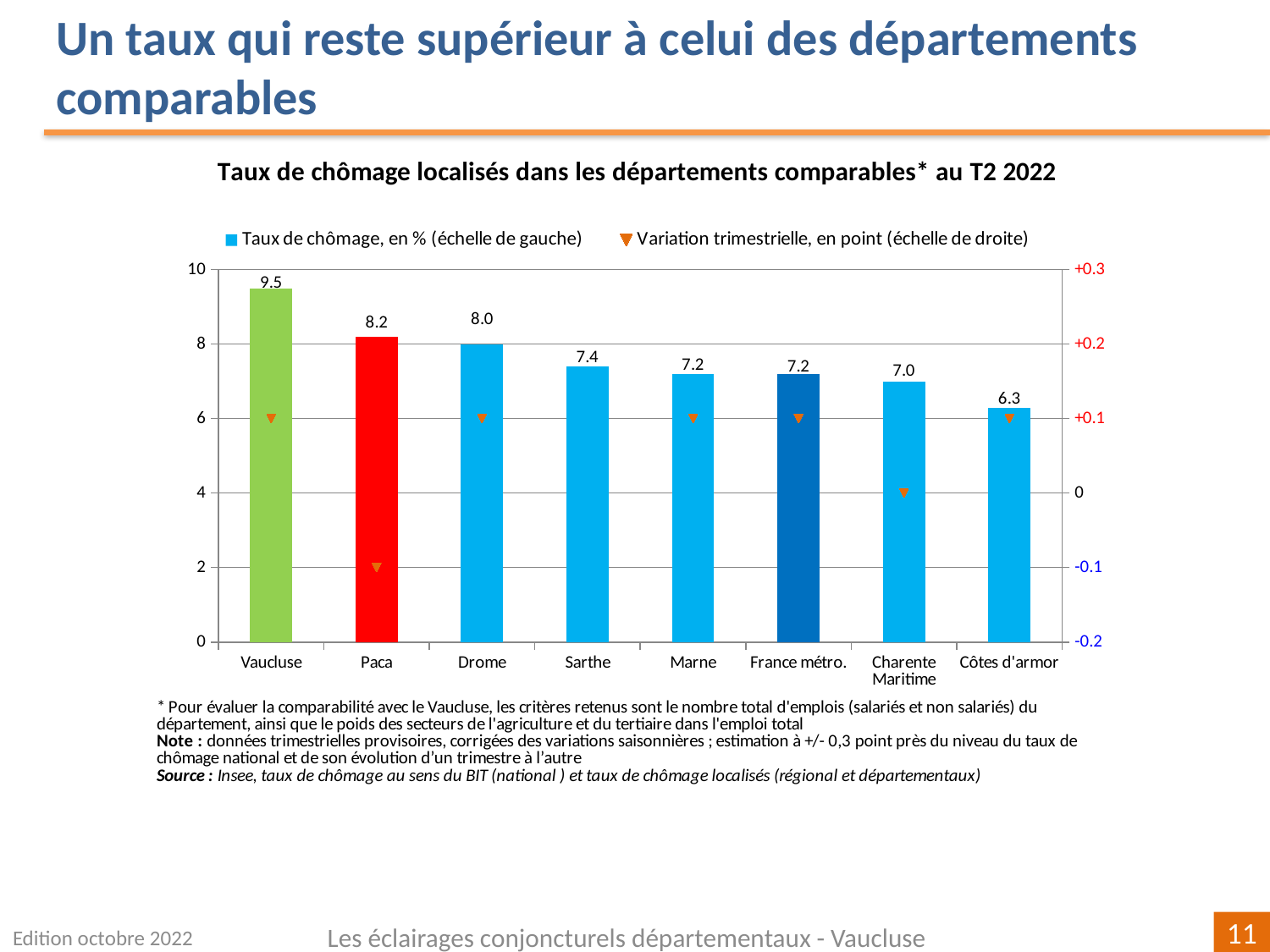
What kind of chart is used to show the unemployment rates? Bar chart How many series does the legend list? 2 What is the difference between the unemployment rate of Vaucluse and that of France métro.? 2.3 Which has a higher unemployment rate, Paca or Drome? Paca Which department has the highest unemployment rate in the chart? Vaucluse What is the quarterly variation shown for Charente Maritime on the right-hand scale? 0 What is the unemployment rate shown for Côtes d'armor? 6.3 What is the quarterly variation (Variation trimestrielle) shown for Paca on the right-hand scale? -0.1 Which category has the lowest unemployment rate in the chart? Côtes d'armor What is the title of the chart? Taux de chômage localisés dans les départements comparables* au T2 2022 What is the unemployment rate (Taux de chômage) shown for Vaucluse? 9.5 How many categories are shown on the x axis of the chart? 8